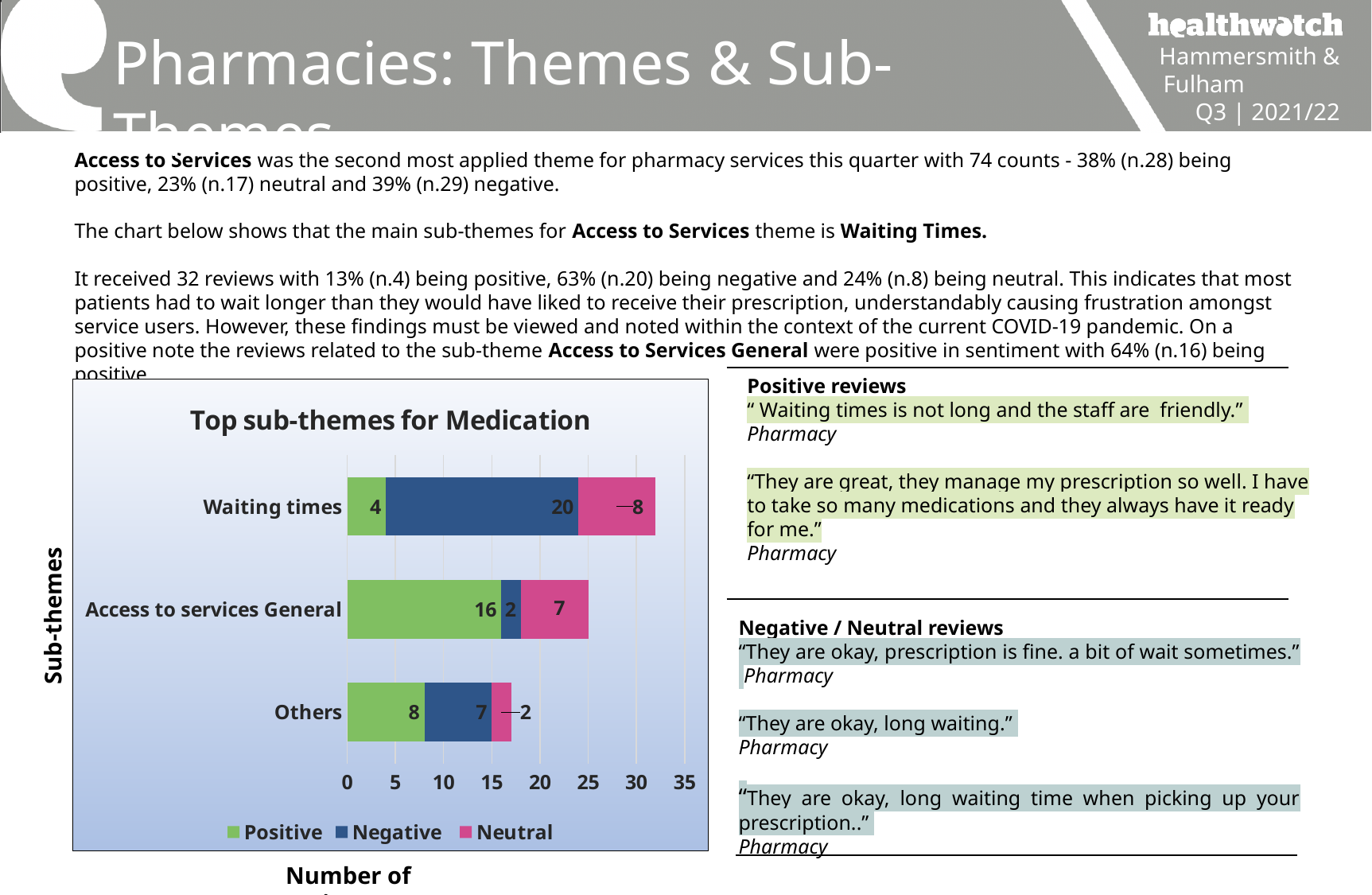
What is the total of the stacked bar for Waiting times? 32 What is the Neutral value for Others? 2 What is the difference between the Negative value for Waiting times and the Negative value for Others? 13 Which sub-theme has the lowest Positive value? Waiting times How many series does the chart legend list? 3 What is the Negative value for Waiting times? 20 What type of chart is shown on the slide? Stacked bar chart Which sub-theme has the highest Negative value? Waiting times Is the Neutral value for Access to services General larger or smaller than the Neutral value for Waiting times? Smaller What is the Positive value for Access to services General? 16 How many sub-theme categories are plotted in the chart? 3 What is the title of the chart? Top sub-themes for Medication